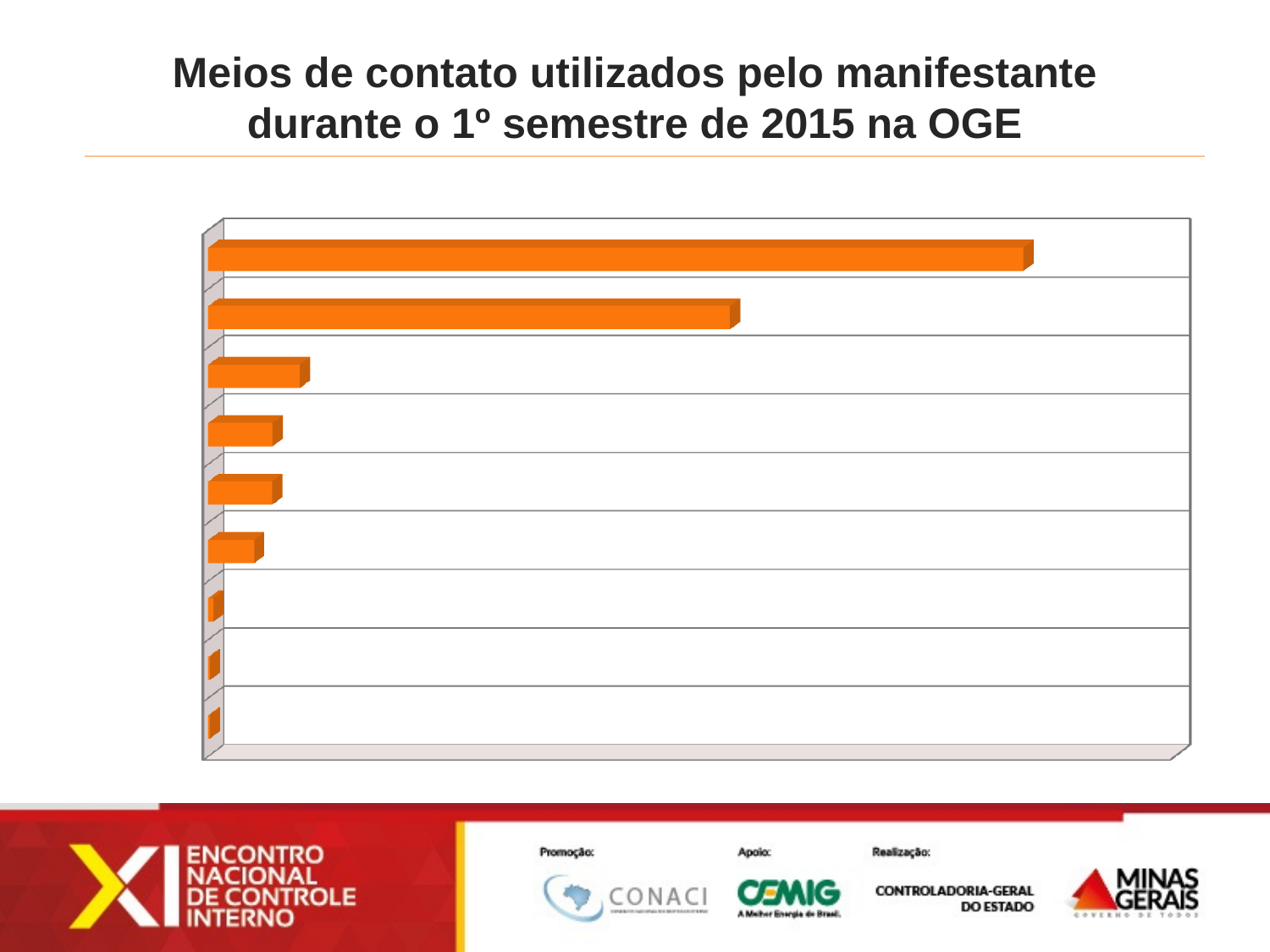
What colour are the bars in the chart? orange Which bar is the longest: the top bar or the second bar from the top? the top bar What is the title of the slide containing the chart? Meios de contato utilizados pelo manifestante durante o 1º semestre de 2015 na OGE Are the bars in the chart horizontal or vertical? horizontal How many bars does the chart contain? 9 What kind of chart is shown on the slide? bar chart Do the bar lengths increase or decrease from the top of the chart to the bottom? decrease